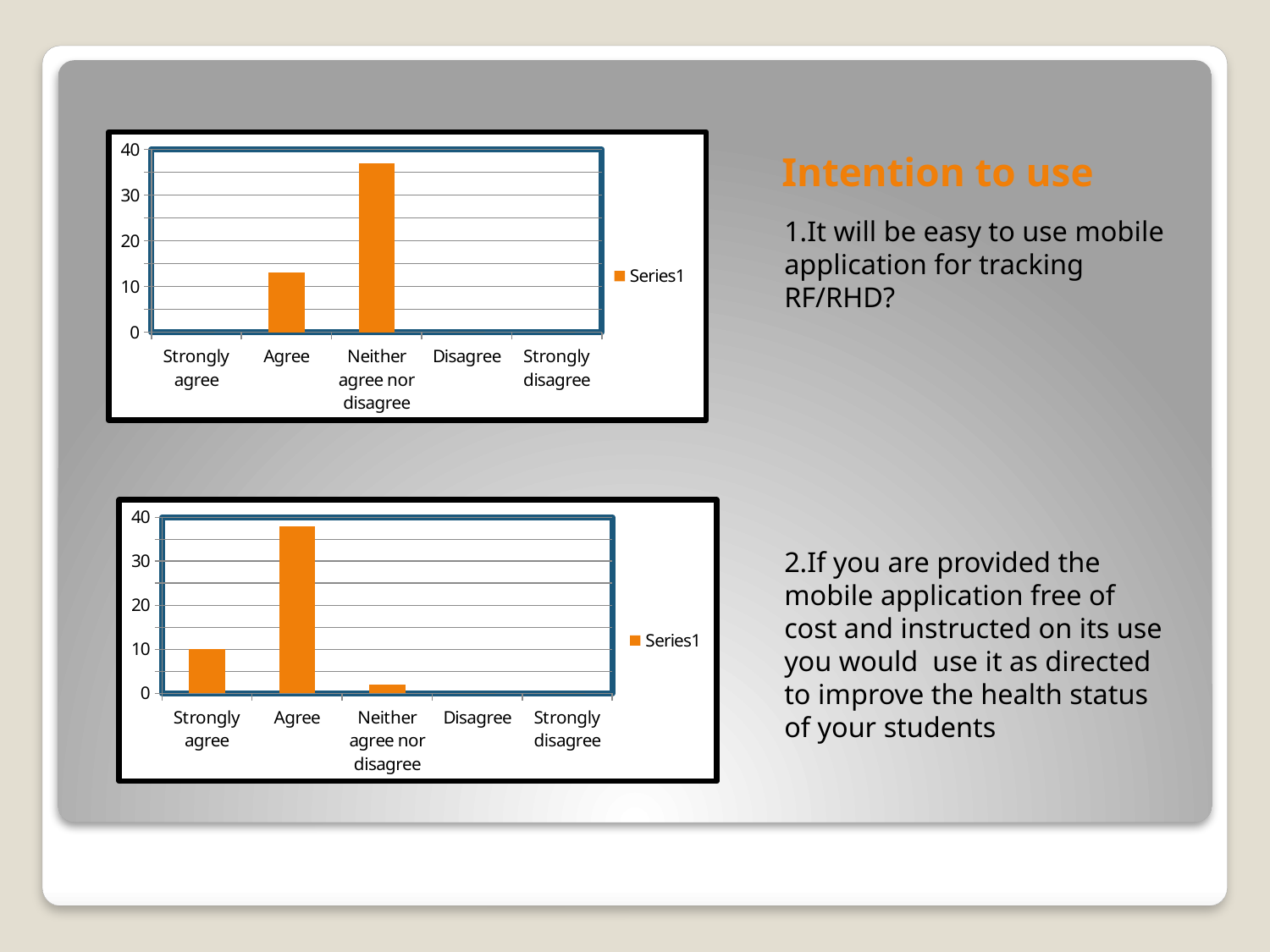
In the bottom chart, is the value for Neither agree nor disagree greater or less than 10? less In the bottom chart, is the value for Agree greater or less than 30? greater In the bottom chart, which is larger, the value for Strongly agree or the value for Agree? Agree In the top chart, which is larger, the value for Agree or the value for Neither agree nor disagree? Neither agree nor disagree In the bottom chart, which category has the highest value? Agree How many categories are shown on the x axis of the top chart? 5 What kind of chart is the top chart? bar chart In the top chart, which category has the highest value? Neither agree nor disagree In the top chart, is the value for Neither agree nor disagree greater or less than 30? greater How many series does the legend of the bottom chart list? 1 What is the legend entry shown in the bottom chart? Series1